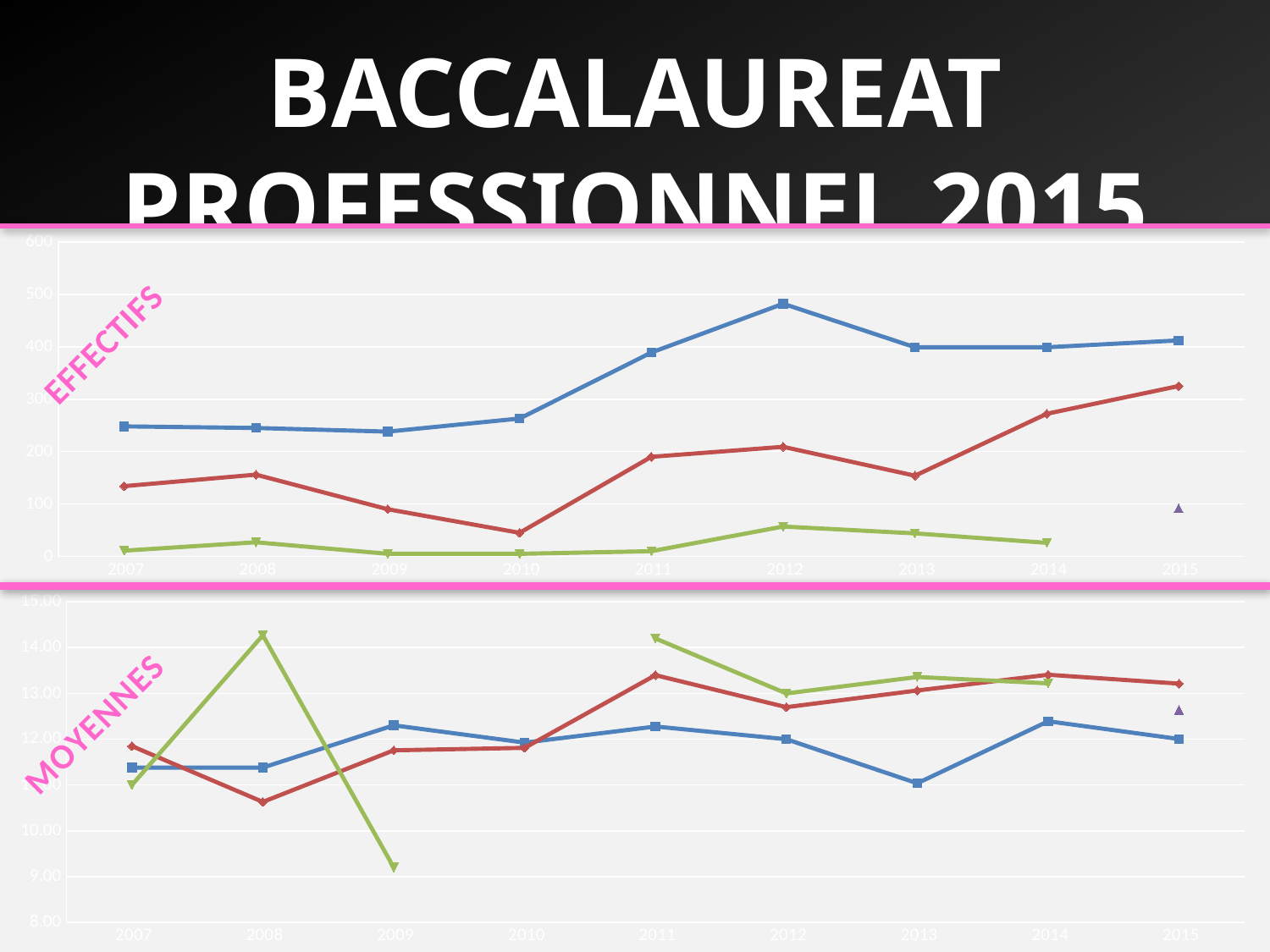
In the EFFECTIFS chart, in which year does the blue line reach its highest value? 2012 In the MOYENNES chart, in which year does the green line reach its lowest value? 2009 How many years are shown on the x axis of the EFFECTIFS chart? 9 What kind of chart is the top chart labelled EFFECTIFS? line chart What is the label written beside the bottom chart? MOYENNES In the EFFECTIFS chart, is the blue line's value for 2012 greater or less than 500? less In the MOYENNES chart, is the red line's value for 2008 greater or less than 11.00? less In the EFFECTIFS chart, does the blue line rise or fall between 2010 and 2012? rise In the EFFECTIFS chart, in which year does the red line reach its lowest value? 2010 In the EFFECTIFS chart, is the green line's value for 2012 greater or less than 100? less